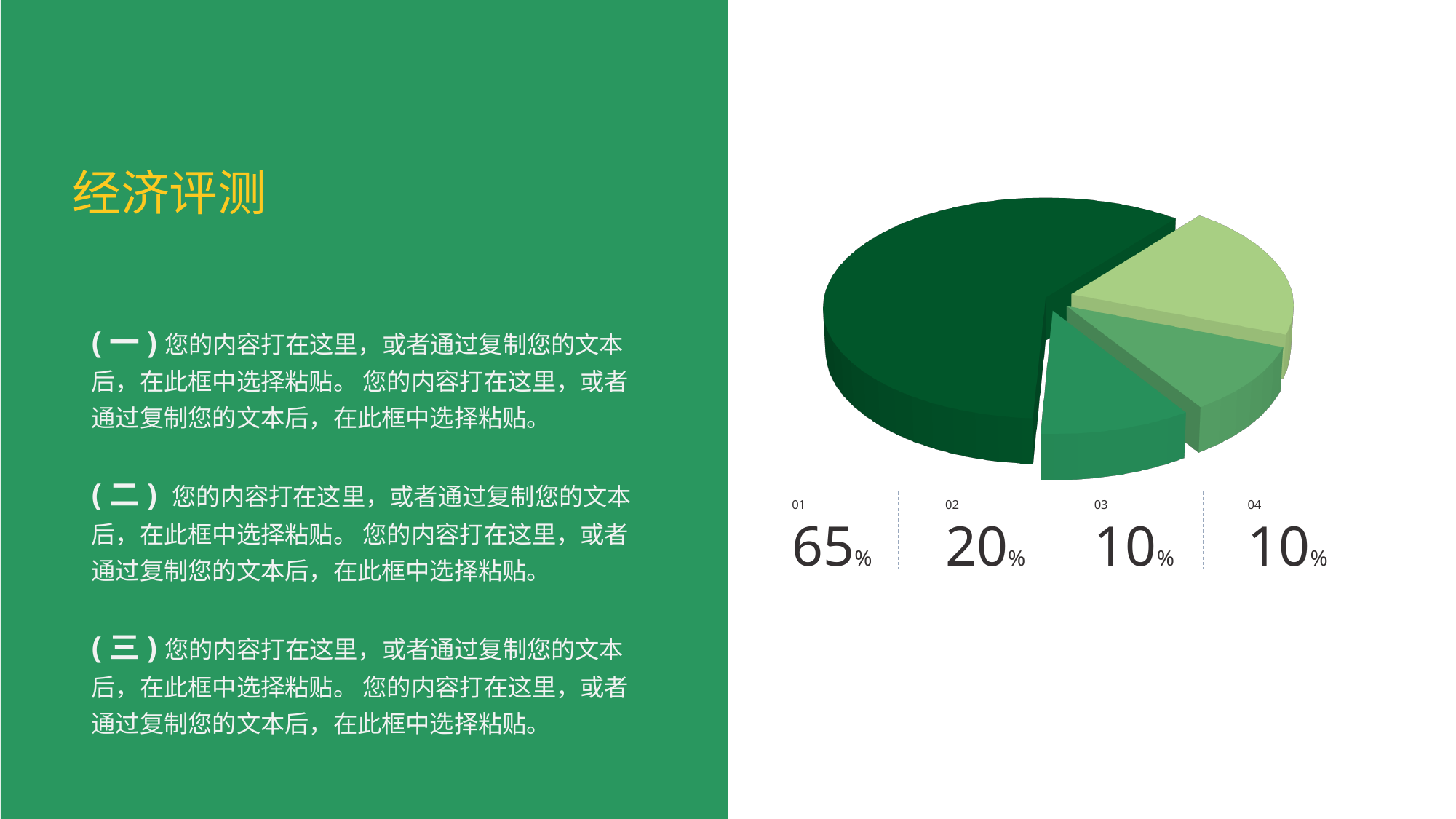
What is the title of the slide containing the pie chart? 经济评测 Is the value for item 01 greater or less than 50%? greater Which is larger, the value for item 02 or the value for item 03? item 02 What kind of chart is shown on the slide? pie chart What is the smallest percentage shown for any slice? 10% What percentage is shown for item 01? 65% What percentage is shown for item 02? 20% Which item has the largest share of the pie? 01 What percentage is shown for item 03? 10% What is the difference between the percentages for item 01 and item 02? 45% How many slices does the pie chart have? 4 What percentage is shown for item 04? 10%